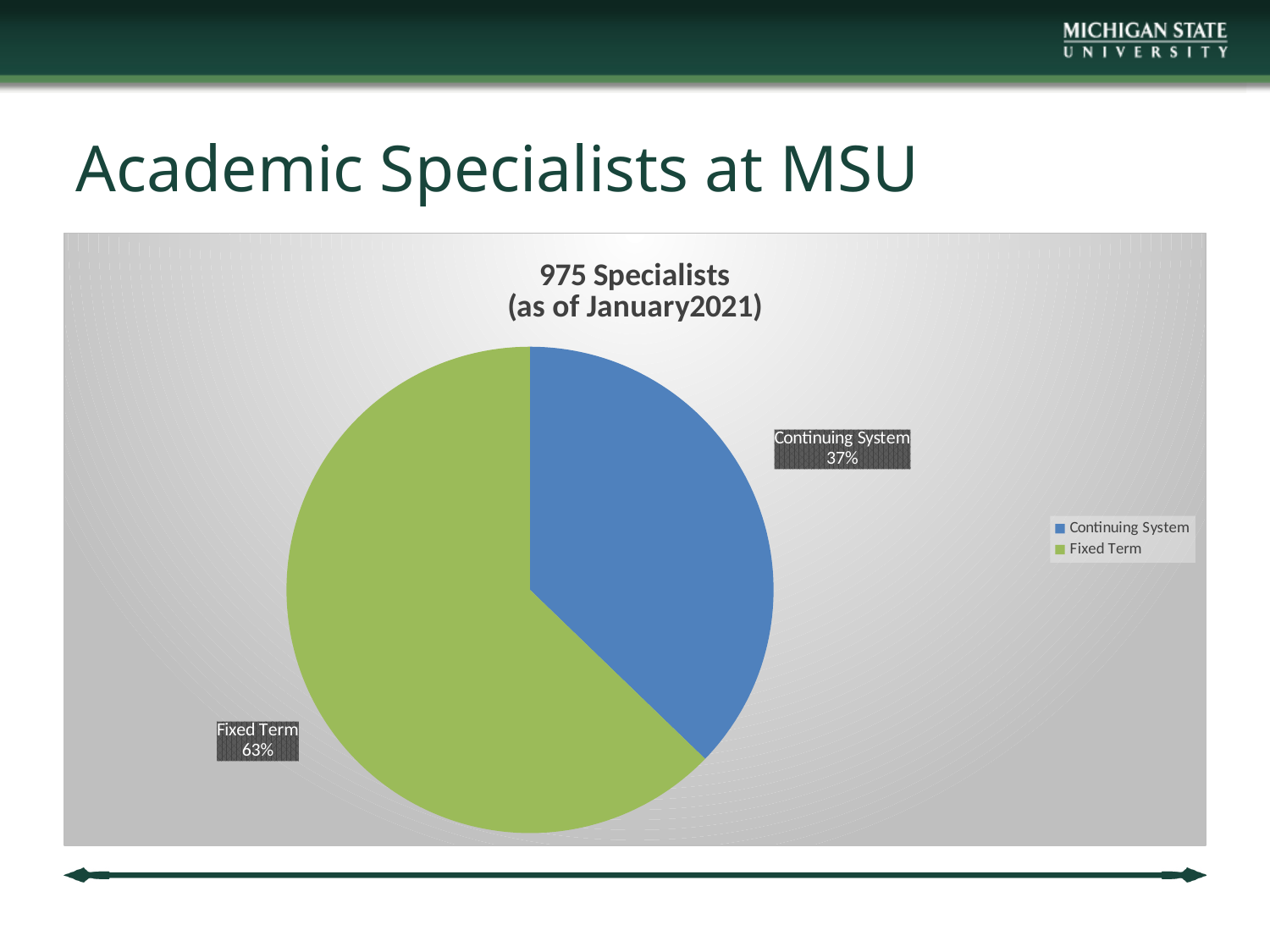
Which is larger, the Continuing System slice or the Fixed Term slice? Fixed Term How many entries does the legend list? 2 What colour is the Fixed Term slice? green What kind of chart is shown on the slide? pie chart What share of the pie does Fixed Term represent? 63% What share of the pie does Continuing System represent? 37% How many categories are shown in the pie chart? 2 What is the title of the chart? 975 Specialists (as of January2021) Which category has the largest slice of the pie? Fixed Term Which category has the smallest slice of the pie? Continuing System Is the share for Continuing System greater or less than 50%? less What is the difference in percentage points between the Fixed Term and Continuing System slices? 26